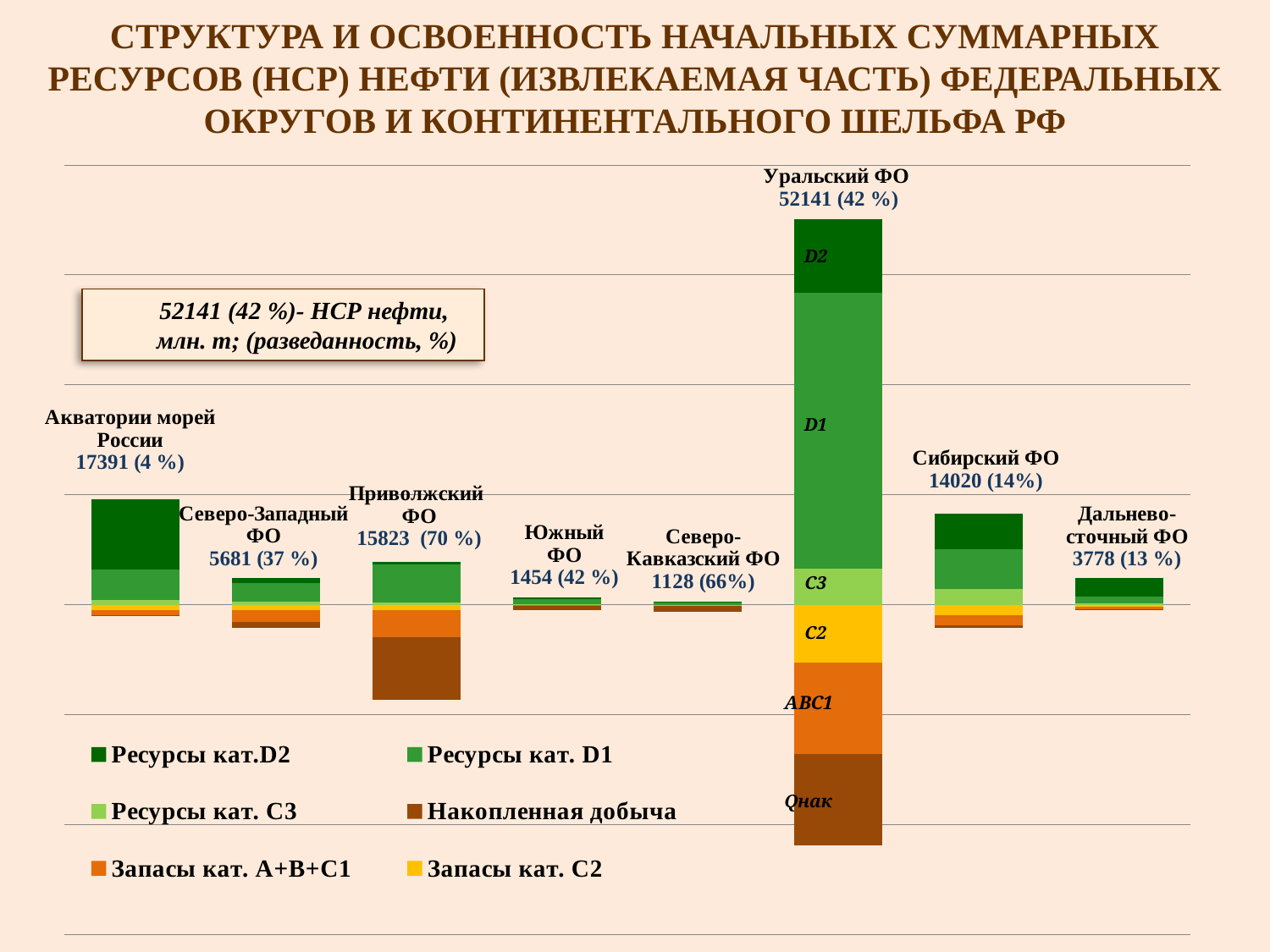
What is the difference between the total NSR values of Уральский ФО and Сибирский ФО? 38121 What kind of chart is shown on the slide? Stacked bar chart How many regions (bars) are shown in the chart? 8 Which has a larger total NSR value, Северо-Западный ФО or Дальневосточный ФО? Северо-Западный ФО How many series does the legend list? 6 What is the difference between the total NSR values of Акватории морей России and Приволжский ФО? 1568 What total NSR value is labelled for Уральский ФО? 52141 (42 %) What total NSR value is labelled for Северо-Кавказский ФО? 1128 (66%) Which region has the lowest total NSR value? Северо-Кавказский ФО What total NSR value is labelled for Приволжский ФО? 15823 (70 %) What exploration percentage is shown for Акватории морей России? 4 % Which region has the highest total NSR value? Уральский ФО